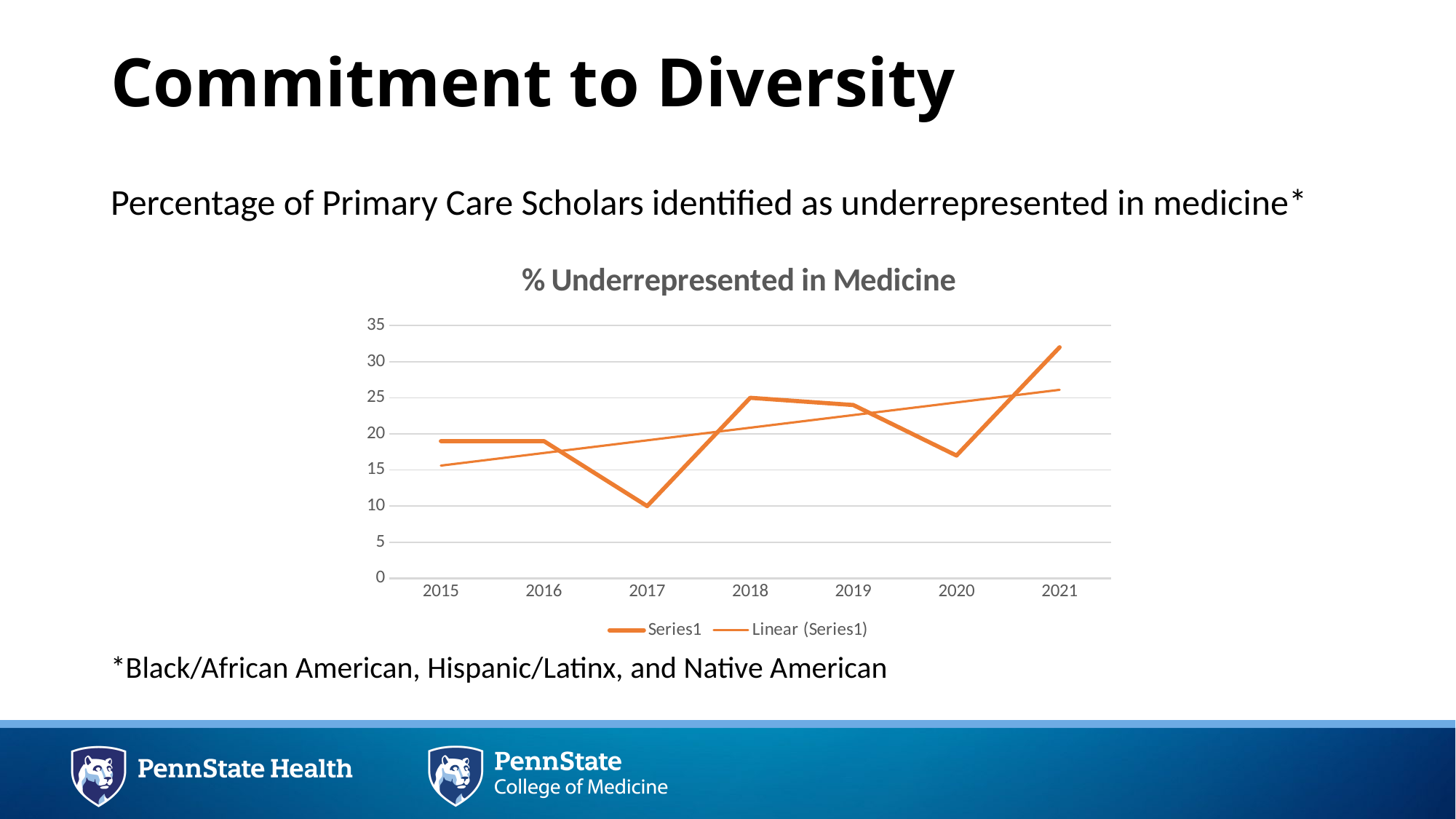
Which year has the lowest value for Series1? 2017 Which year has the highest value for Series1? 2021 How many years are plotted on the x axis? 7 Is the Series1 value for 2020 greater or less than 20? less What kind of chart is shown on the slide? line chart Is the Series1 value for 2019 greater or less than 20? greater What is the title of the chart? % Underrepresented in Medicine Which year has the larger Series1 value, 2018 or 2020? 2018 Is the Series1 value for 2021 greater or less than 30? greater Does the Linear (Series1) trendline rise or fall from 2015 to 2021? rise What are the two entries listed in the chart legend? Series1 and Linear (Series1) How many series does the legend list? 2